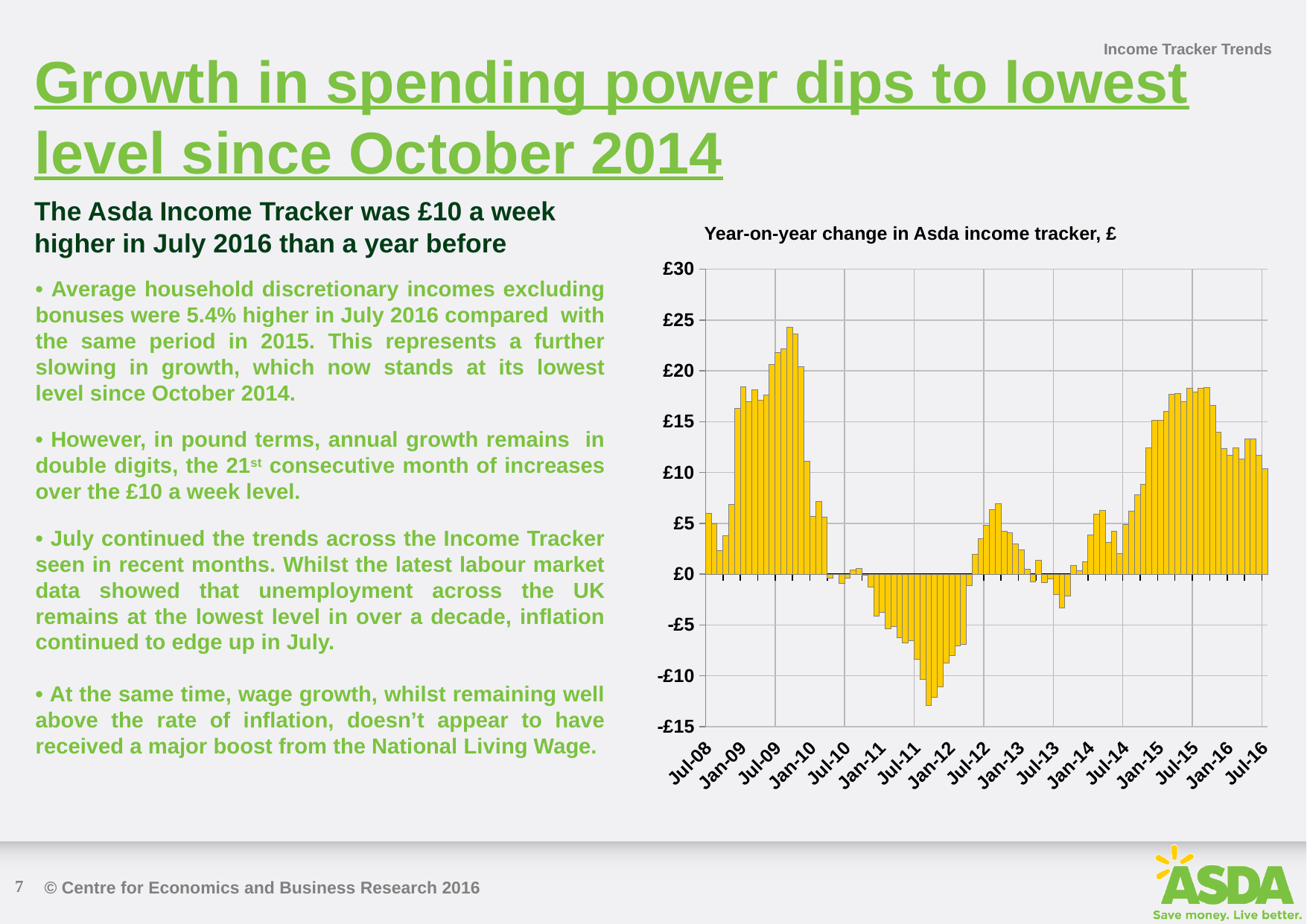
What is the title of the chart? Year-on-year change in Asda income tracker, £ What kind of chart is shown on the slide? Bar chart Do the values generally rise or fall between Jan-14 and Jul-15? rise Do the values generally rise or fall between Jul-15 and Jul-16? fall How many date labels are shown along the x axis of the chart? 17 Is the value for Jan-09 greater or less than £10? greater Is the highest bar on the chart greater or less than £20? greater Is the value for Jan-12 greater or less than -£5? less